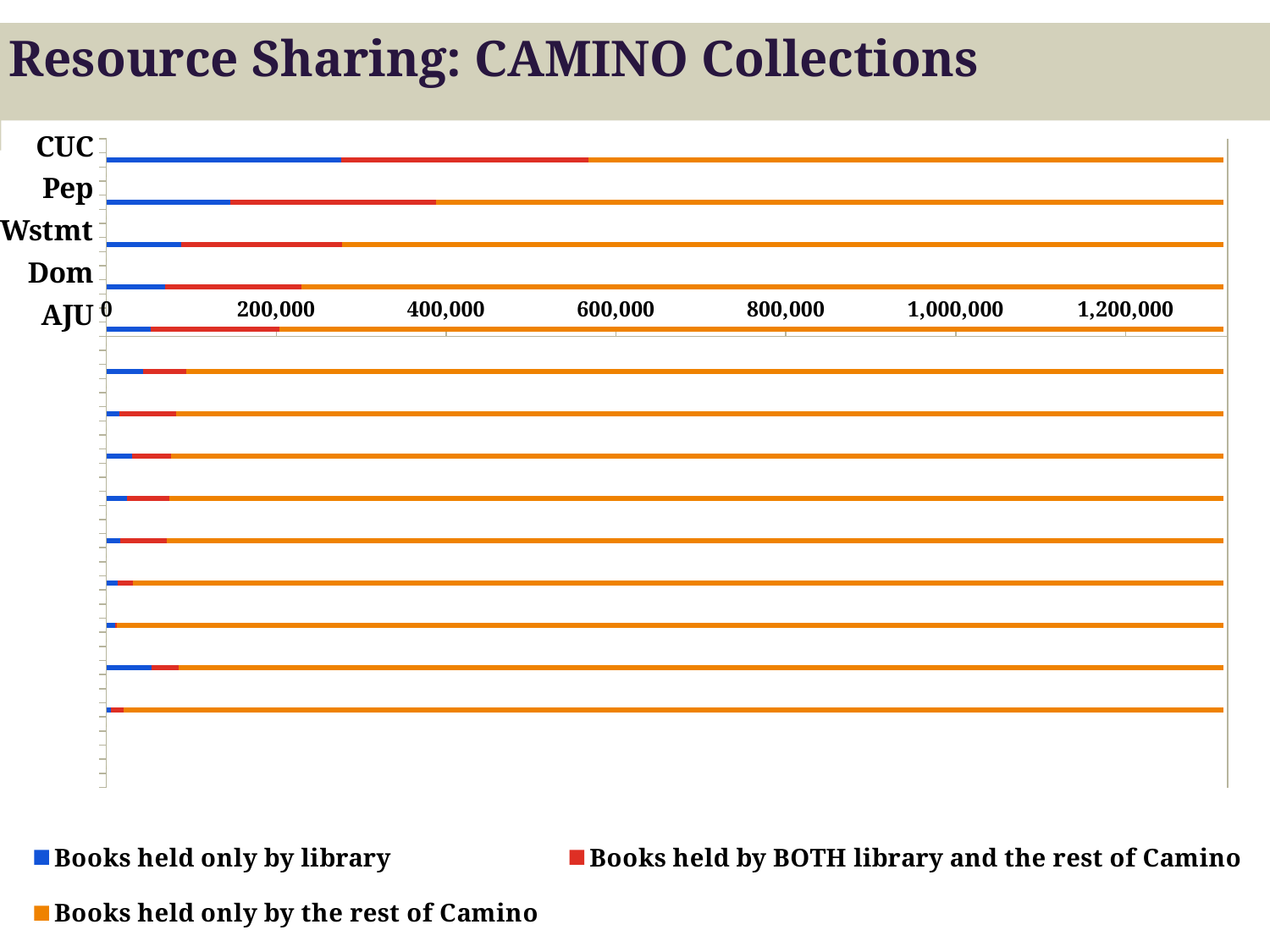
What kind of chart is shown on the slide? Stacked horizontal bar chart Which series is shown in orange in the legend? Books held only by the rest of Camino Is the value of Books held only by library for AJU greater or less than 200,000? less Is the value of Books held only by library for Wstmt greater or less than 200,000? less Among the labeled libraries CUC, Pep, Wstmt, Dom and AJU, which has the largest Books held only by library segment? CUC Which has the larger Books held only by library segment, Dom or Wstmt? Wstmt Is the value of Books held only by library for CUC greater or less than 200,000? greater What is the title of the slide containing the chart? Resource Sharing: CAMINO Collections How many series does the legend list? 3 Which has the larger Books held only by library segment, CUC or Pep? CUC Going down from CUC to AJU, does the Books held only by library segment increase or decrease? decrease